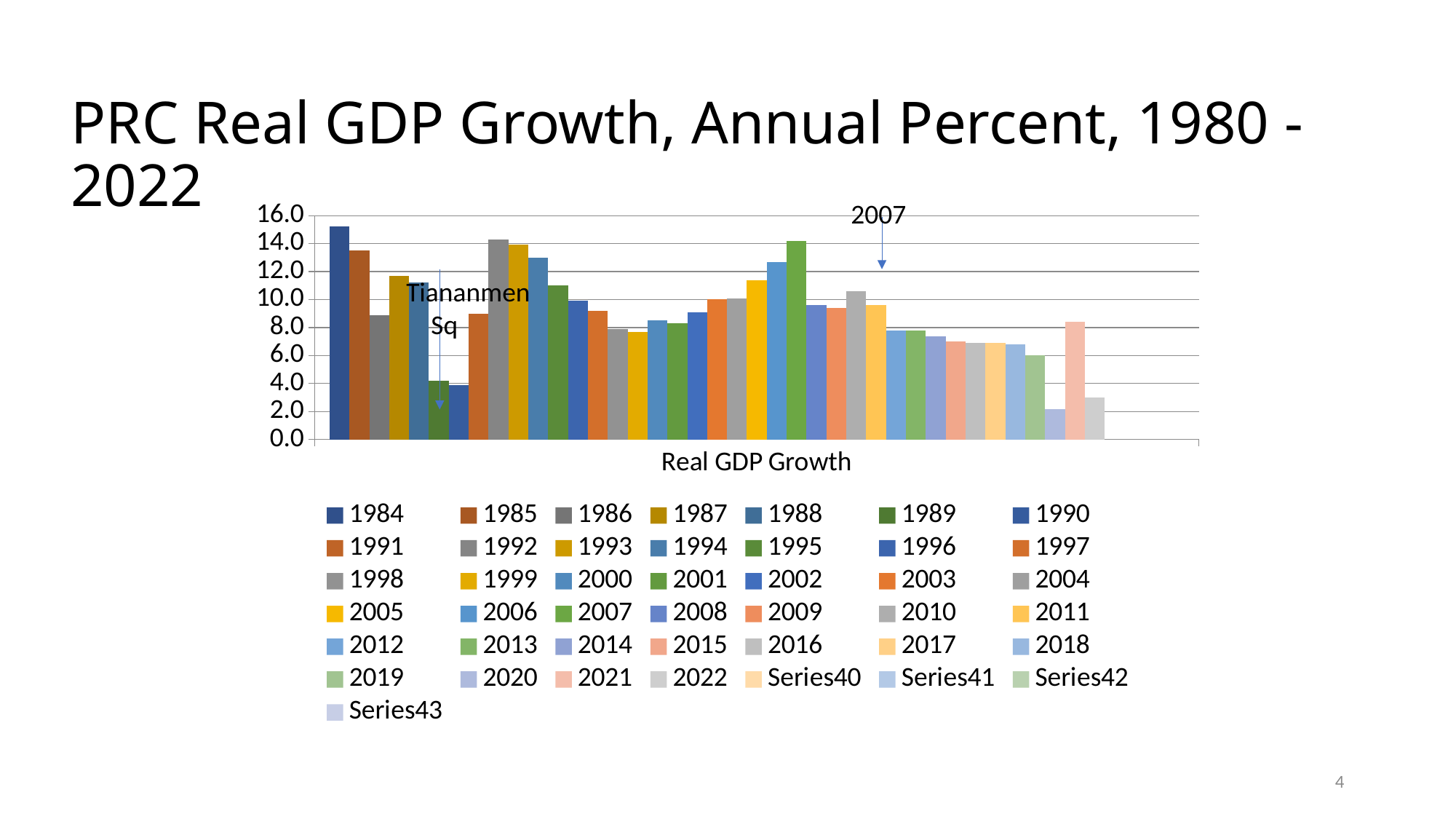
Which year has the lowest real GDP growth bar? 2020 What kind of chart is shown on the slide? Bar chart Is the value for 2022 greater or less than 4.0? less Is the value for 1984 greater or less than 14.0? greater How many entries does the chart legend list? 43 Which is larger, the value for 2020 or the value for 2021? 2021 Do the bars rise or fall from 2010 through 2019? fall Which year has the highest real GDP growth bar? 1984 Which is larger, the value for 1984 or the value for 1985? 1984 Is the value for 1989 greater or less than 6.0? less What is the title of the slide containing the chart? PRC Real GDP Growth, Annual Percent, 1980 - 2022